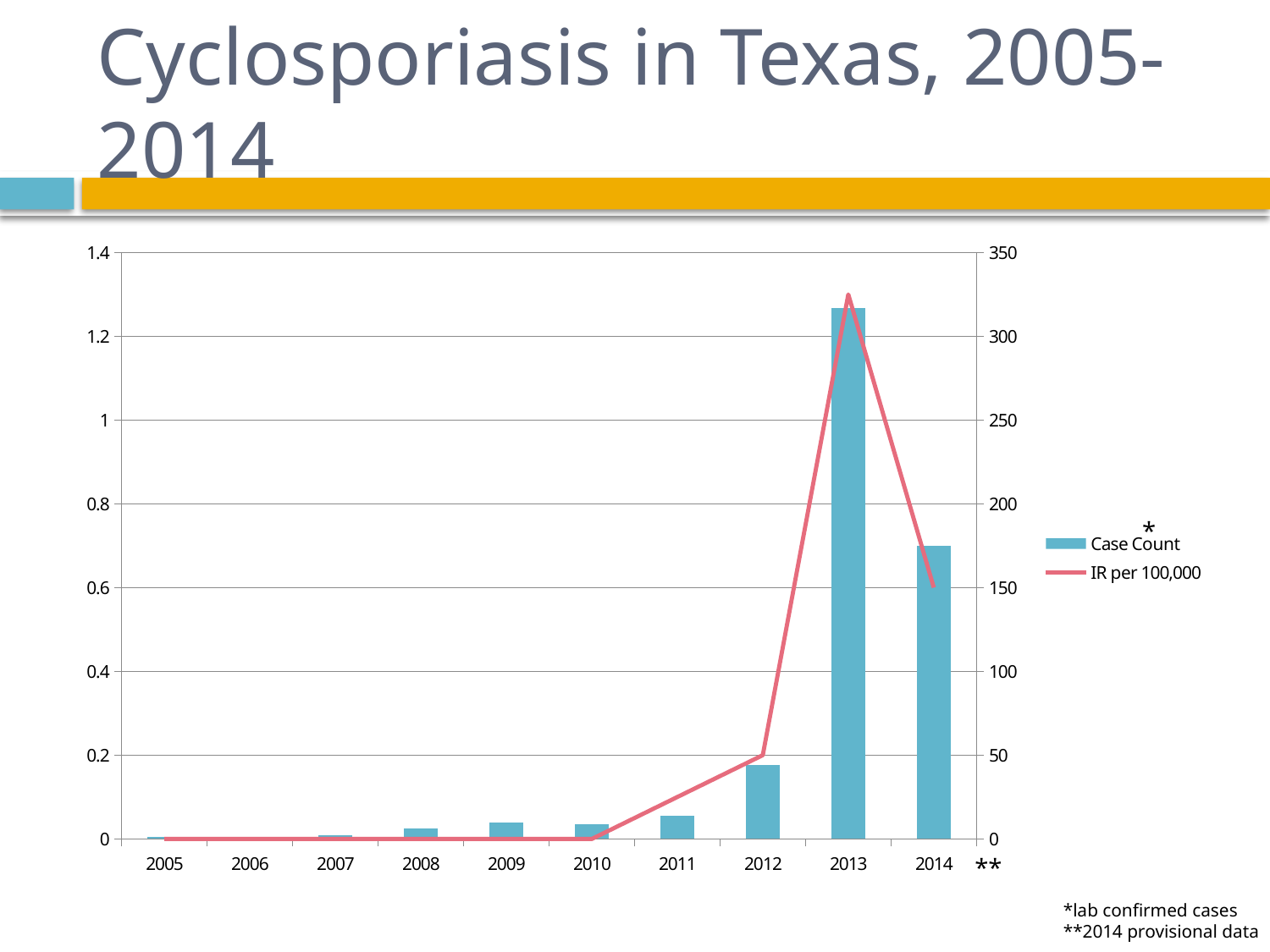
Does the Case Count rise or fall from 2010 to 2013? rise What kind of chart is shown on the slide? A bar chart combined with a line chart What is the title of the slide containing the chart? Cyclosporiasis in Texas, 2005-2014 Is the Case Count for 2013 greater or less than 300? greater How many years are shown along the x axis of the chart? 10 Which year has the larger Case Count, 2013 or 2014? 2013 Is the Case Count for 2012 greater or less than 50? less Is the Case Count for 2014 greater or less than 150? greater Which year has the highest Case Count? 2013 How many series does the chart's legend list? 2 What are the two series named in the chart's legend? Case Count and IR per 100,000